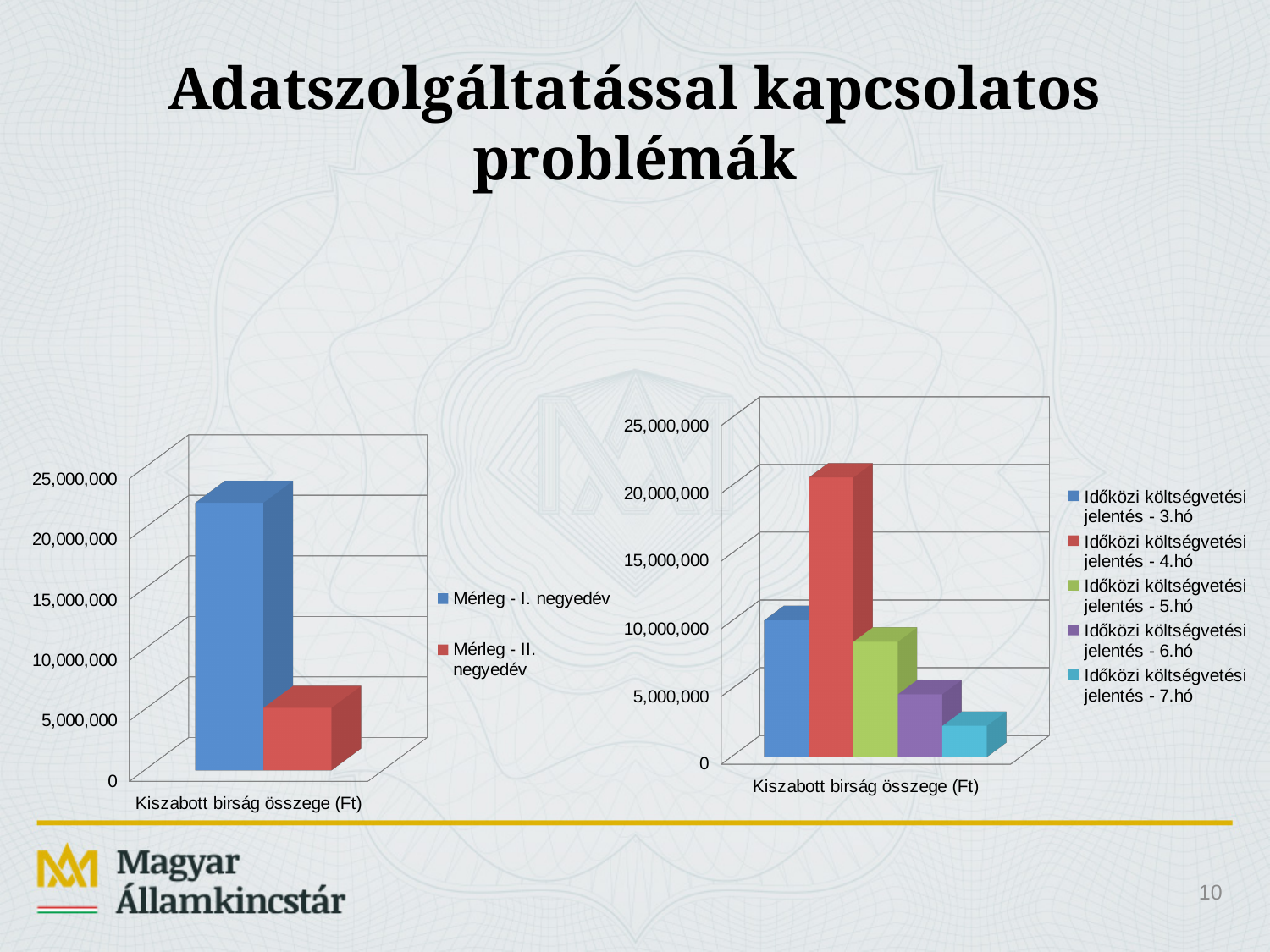
In the right chart, is the value for Időközi költségvetési jelentés - 7.hó greater or less than 5,000,000? less In the left chart, which series has the higher value: Mérleg - I. negyedév or Mérleg - II. negyedév? Mérleg - I. negyedév In the right chart, which series has the lowest value? Időközi költségvetési jelentés - 7.hó In the right chart, which series has the highest value? Időközi költségvetési jelentés - 4.hó What is the category label shown on the x axis of the right chart? Kiszabott birság összege (Ft) In the left chart, is the value for Mérleg - I. negyedév greater or less than 20,000,000? greater How many series does the legend of the left chart list? 2 In the right chart, which series has the larger value: Időközi költségvetési jelentés - 3.hó or Időközi költségvetési jelentés - 6.hó? Időközi költségvetési jelentés - 3.hó How many series does the legend of the right chart list? 5 In the right chart, is the value for Időközi költségvetési jelentés - 5.hó greater or less than 10,000,000? less What kind of chart is the left chart on the slide? bar chart